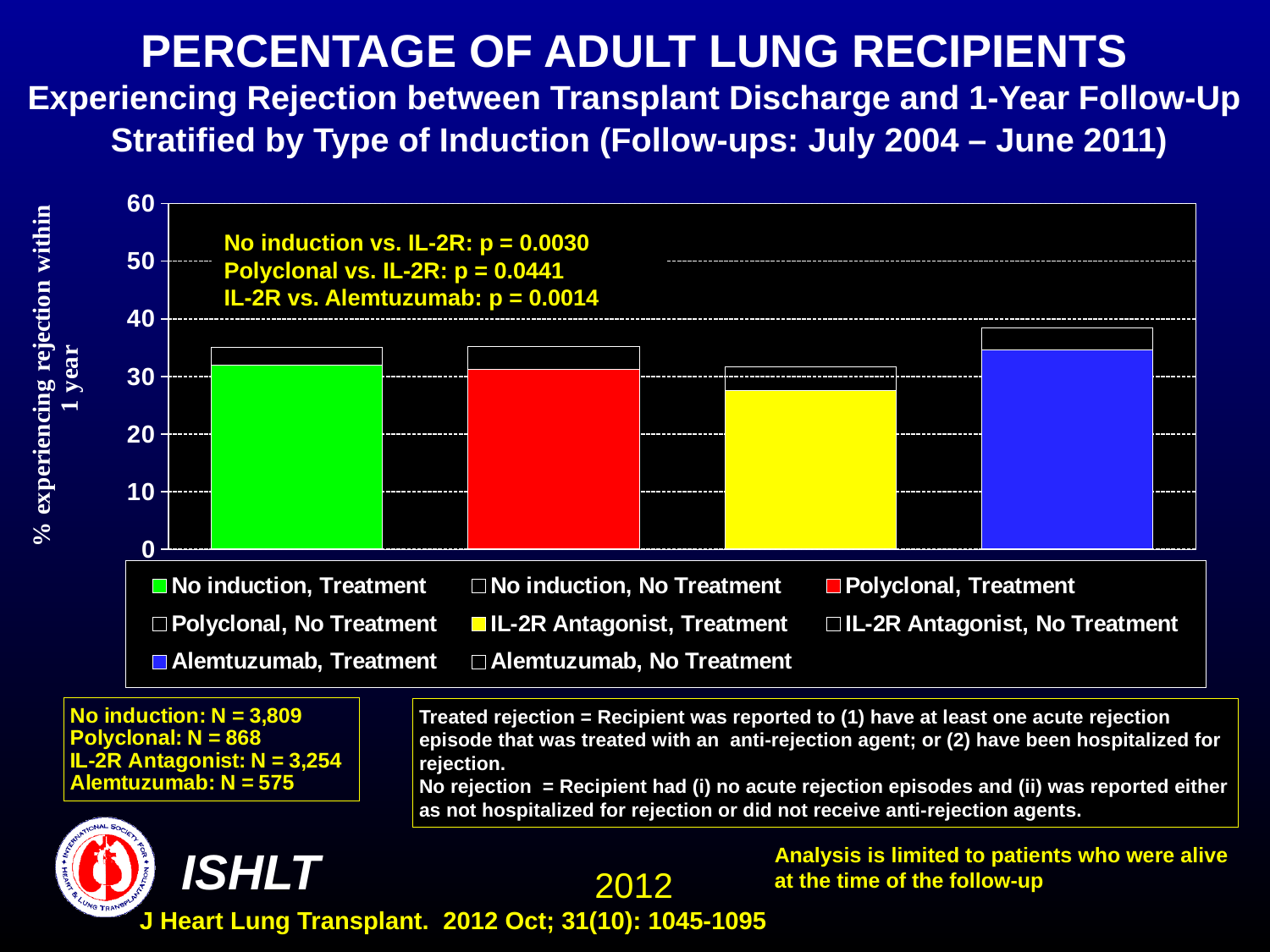
Is the total bar for No induction greater or less than 40? less Is the value for IL-2R Antagonist, Treatment greater or less than 30? less How many series does the legend list? 8 What kind of chart is shown on the slide? Stacked bar chart Is the value for No induction, Treatment greater or less than 20? greater What colour represents the Polyclonal, Treatment series? Red Which is larger: the Treatment segment for IL-2R Antagonist or the Treatment segment for Alemtuzumab? Alemtuzumab How many induction-type bars are plotted in the chart? 4 What p-value is shown for No induction vs. IL-2R? p = 0.0030 Which induction type has the shortest total bar? IL-2R Antagonist Which induction type has the tallest total bar? Alemtuzumab